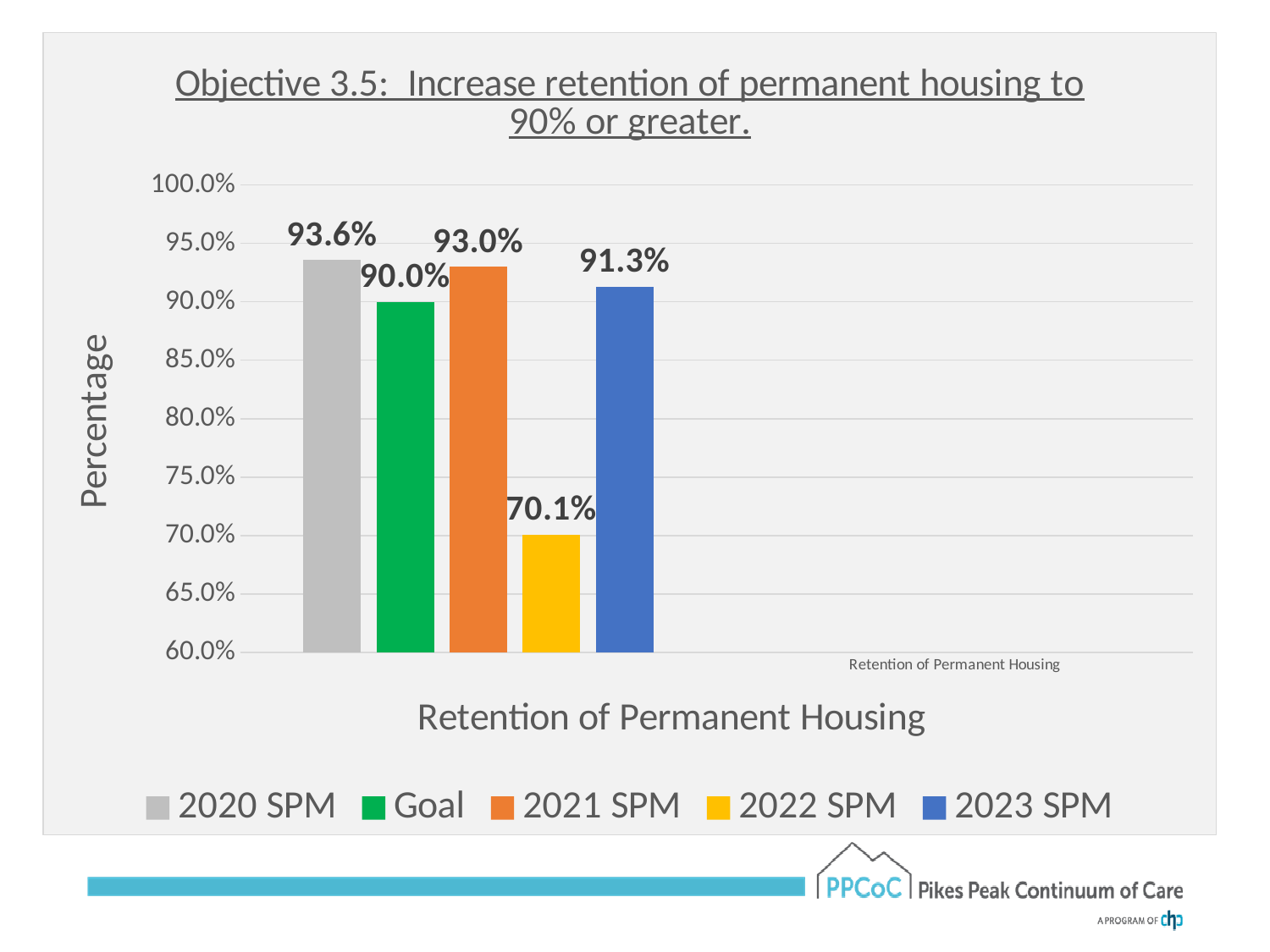
What is the value for 2022 SPM? 70.1% Which is larger, the 2023 SPM value or the Goal value? 2023 SPM What is the value for 2020 SPM? 93.6% Which series has the lowest value? 2022 SPM How many series does the legend list? 5 What is the value for the Goal series? 90.0% Is the value for 2022 SPM greater or less than 75.0%? less What kind of chart is shown on the slide? bar chart What is the label on the vertical axis? Percentage Which series has the highest value? 2020 SPM What is the value for 2023 SPM? 91.3% What is the difference between the 2021 SPM value and the 2022 SPM value? 22.9%